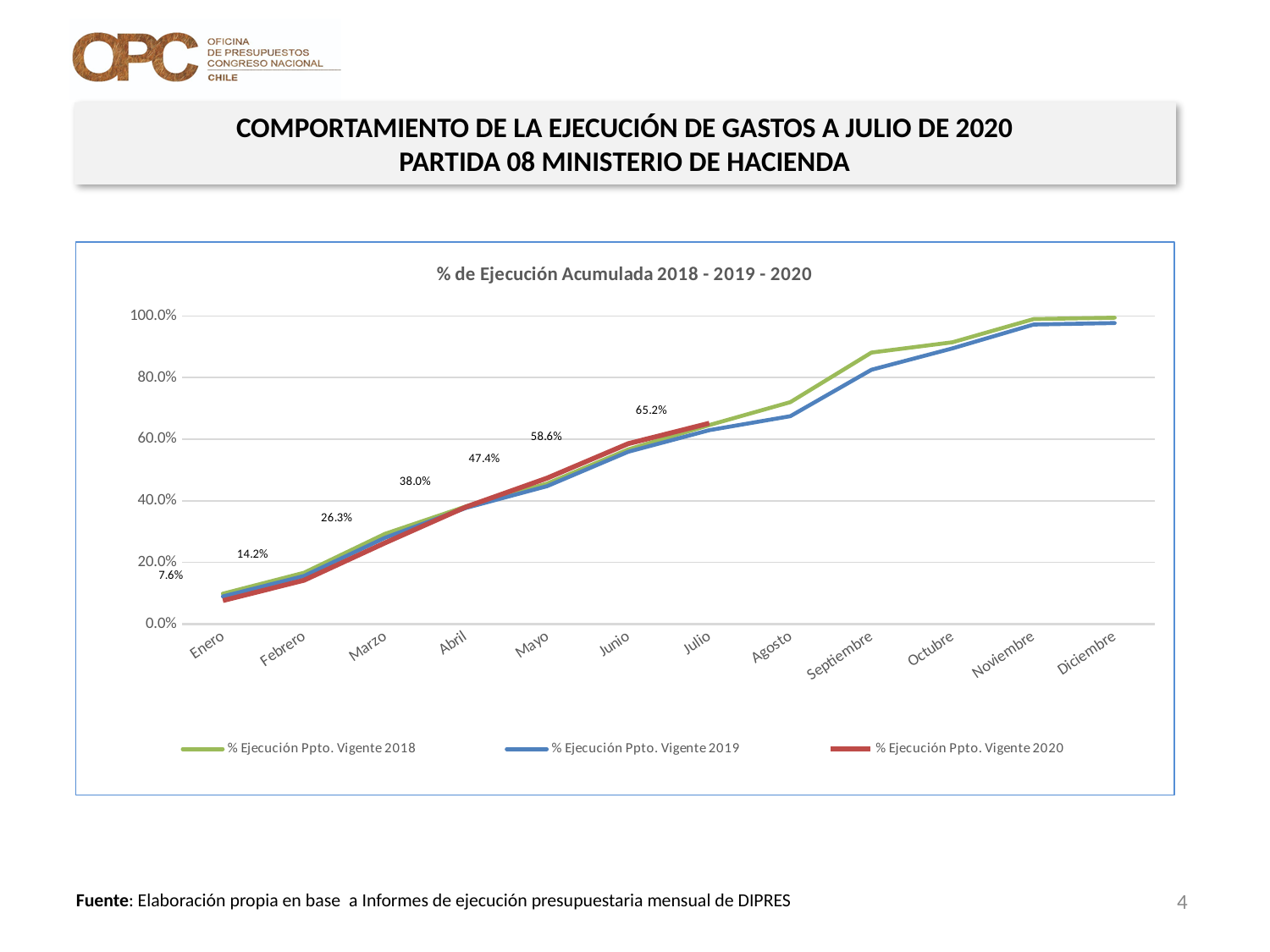
What kind of chart is shown on the slide? Line chart Which month has the lowest labelled value for % Ejecución Ppto. Vigente 2020? Enero What is the value of % Ejecución Ppto. Vigente 2020 for Mayo? 47.4% Which month has the highest labelled value for % Ejecución Ppto. Vigente 2020? Julio What is the value of % Ejecución Ppto. Vigente 2020 for Enero? 7.6% Is the value for % Ejecución Ppto. Vigente 2019 in Agosto greater or less than 80.0%? less What is the value of % Ejecución Ppto. Vigente 2020 for Julio? 65.2% What is the difference between the 2020 values for Julio and Junio? 6.6% Is the value for % Ejecución Ppto. Vigente 2018 in Septiembre greater or less than 80.0%? greater What is the value of % Ejecución Ppto. Vigente 2020 for Abril? 38.0% What is the difference between the 2020 values for Marzo and Febrero? 12.1% How many series does the legend list? 3